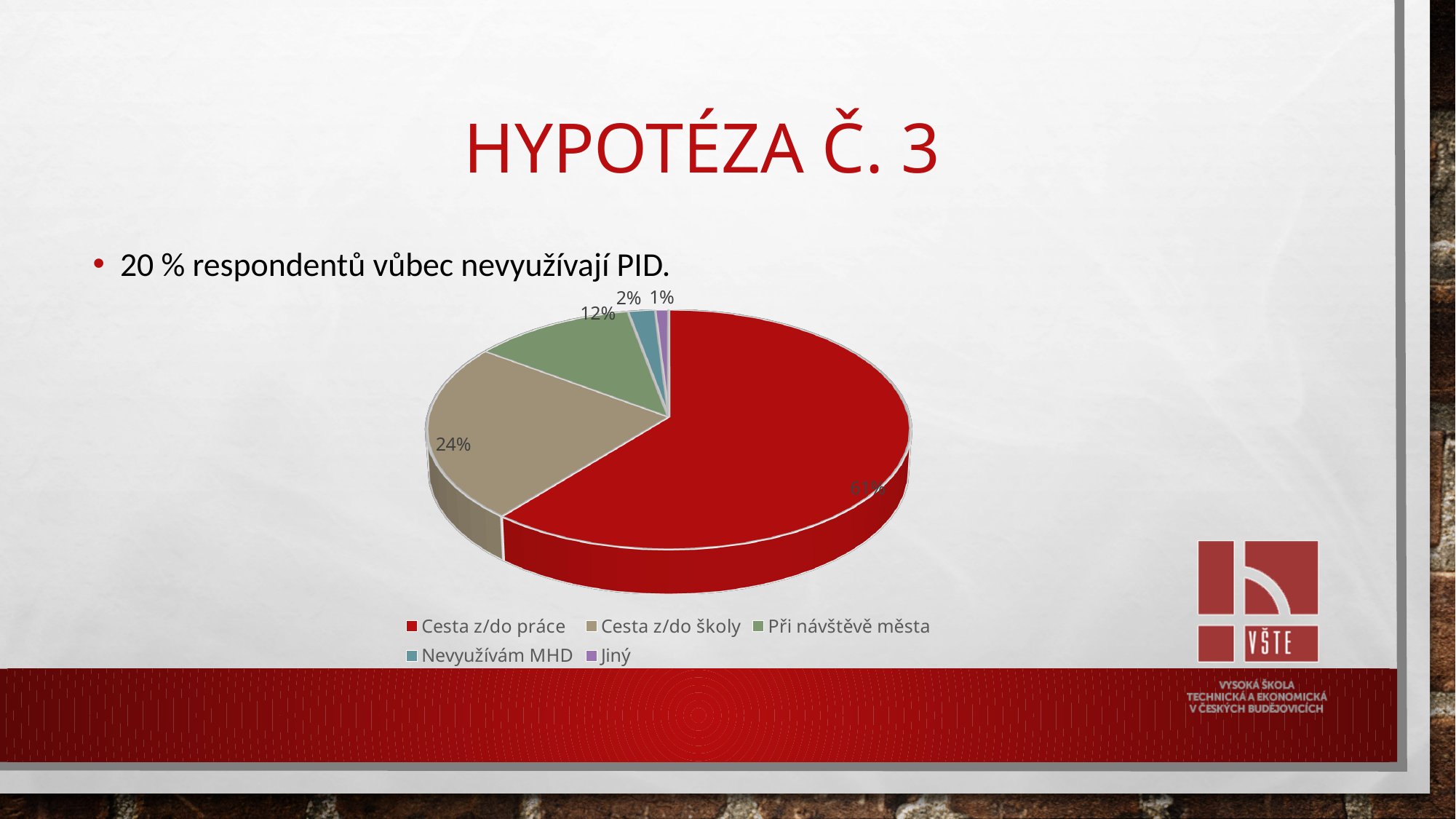
Which is larger, the slice for "Cesta z/do školy" or the slice for "Při návštěvě města"? Cesta z/do školy What colour is the slice for "Cesta z/do práce"? red What share of the pie does "Cesta z/do školy" have? 24% What share of the pie does "Jiný" have? 1% Which category has the largest slice of the pie? Cesta z/do práce What is the difference in percentage points between "Cesta z/do práce" and "Cesta z/do školy"? 37 What kind of chart is shown on the slide? pie chart What share of the pie does "Nevyužívám MHD" have? 2% Which category has the smallest slice of the pie? Jiný How many categories does the legend of the pie chart list? 5 What share of the pie does "Při návštěvě města" have? 12% What share of the pie does "Cesta z/do práce" have? 61%